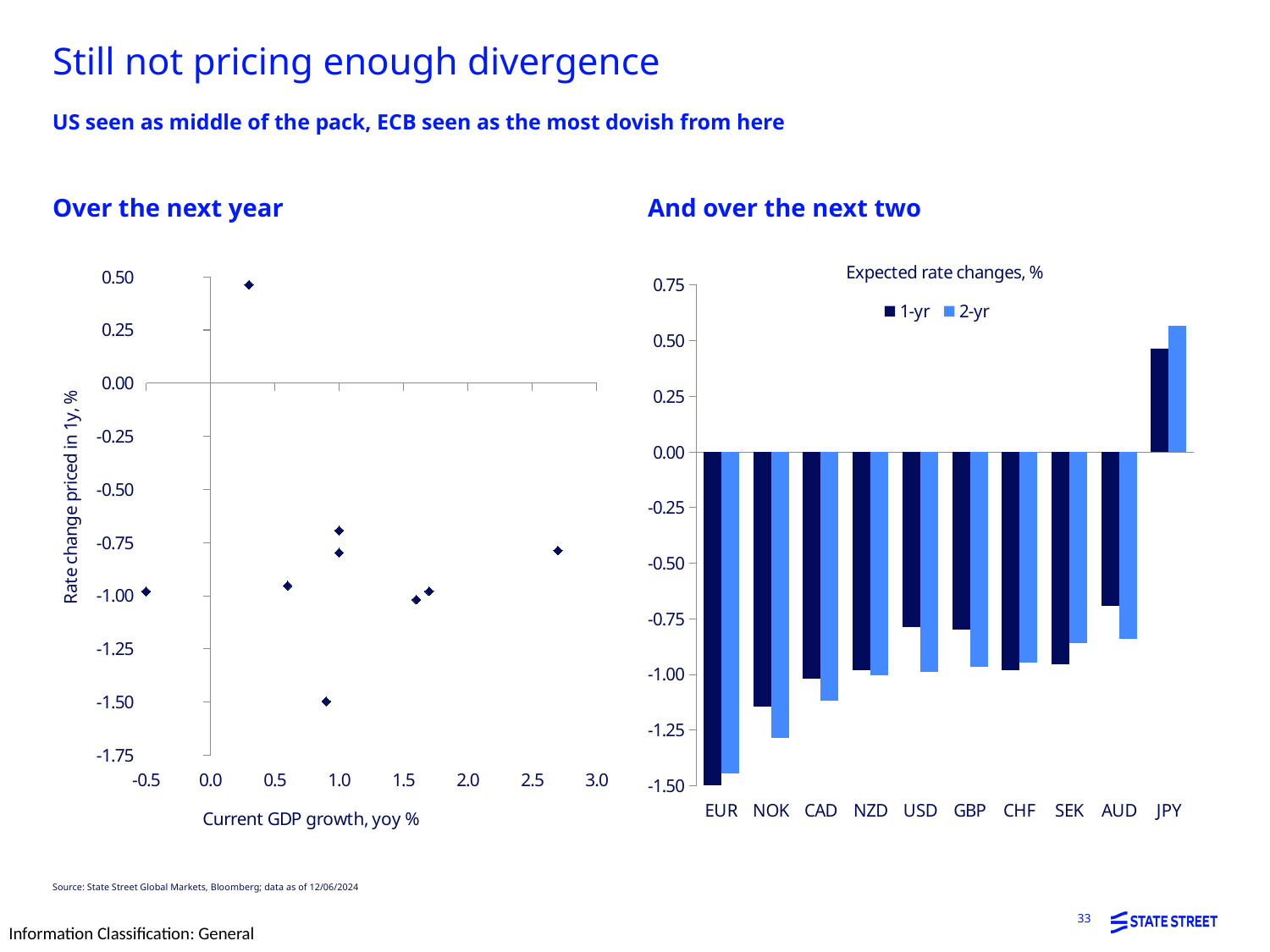
In the right-hand bar chart, do the 1-yr values generally rise or fall moving from EUR to JPY along the x axis? rise In the right-hand bar chart, is the 1-yr value for EUR greater or less than -1.25? less In the right-hand bar chart, is the 2-yr value for JPY greater or less than 0.50? greater In the right-hand bar chart, which currency has the lowest 1-yr expected rate change? EUR What kind of chart is the right-hand chart titled 'Expected rate changes, %'? bar chart What kind of chart is the left-hand chart under 'Over the next year'? scatter chart In the right-hand bar chart, how many series does the legend list? 2 In the right-hand bar chart, which is larger for JPY, the 1-yr value or the 2-yr value? 2-yr In the right-hand bar chart, which currency has the highest expected rate change? JPY In the right-hand bar chart, how many currencies are shown on the x axis? 10 What is the x-axis title of the left-hand scatter chart? Current GDP growth, yoy % In the right-hand bar chart, is the 1-yr value for AUD greater or less than -0.75? greater